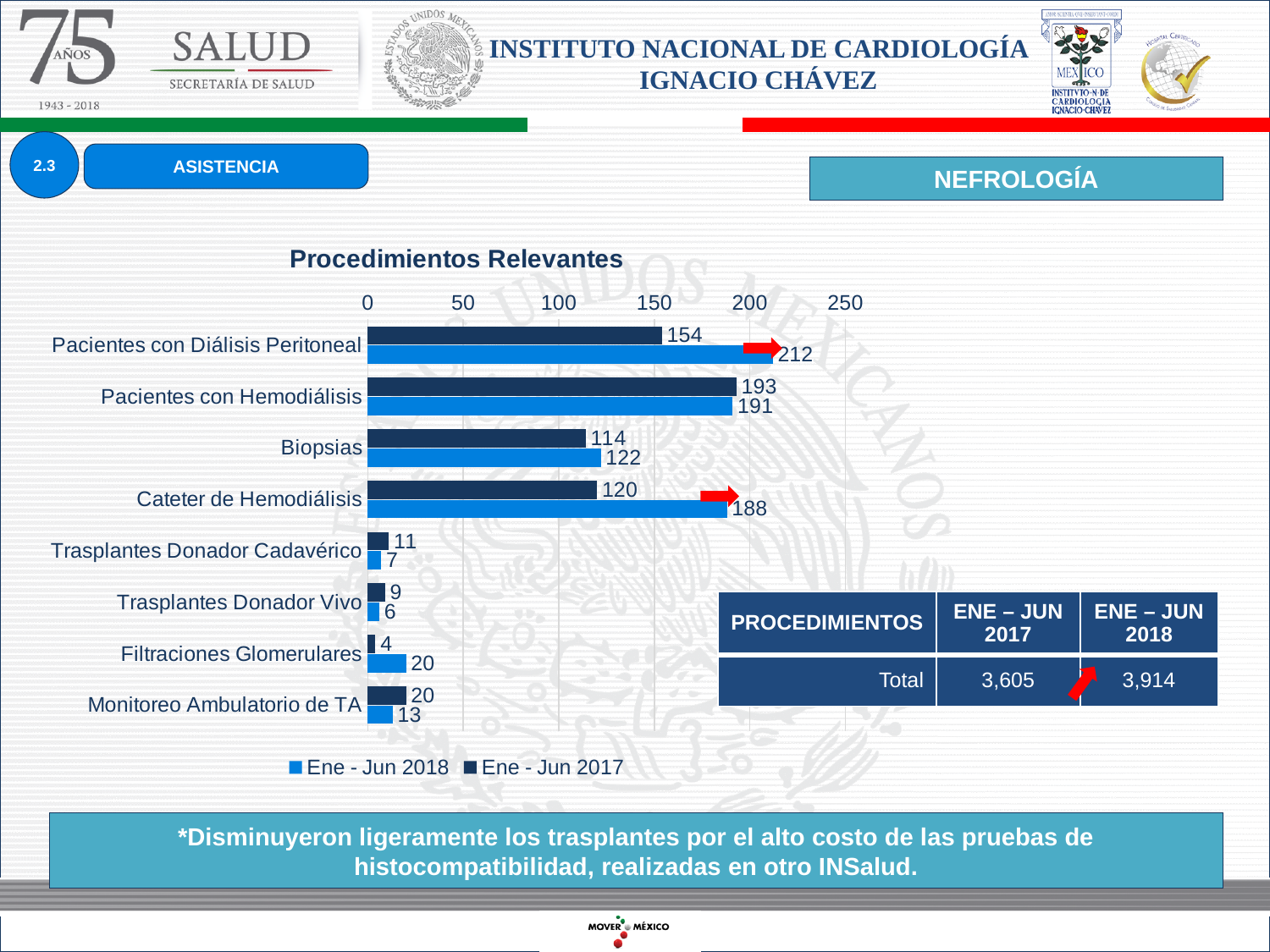
What type of chart is 'Procedimientos Relevantes'? bar chart Which series is shown in light blue in the 'Procedimientos Relevantes' chart? Ene - Jun 2018 Is the Ene - Jun 2017 value for Pacientes con Hemodiálisis greater or less than 150? greater How many categories are shown in the 'Procedimientos Relevantes' chart? 8 Which category has the lowest Ene - Jun 2017 value? Filtraciones Glomerulares How many series does the legend of the 'Procedimientos Relevantes' chart list? 2 What is the Ene - Jun 2018 value for Pacientes con Diálisis Peritoneal? 212 What is the Ene - Jun 2017 value for Cateter de Hemodiálisis? 120 What is the Ene - Jun 2018 value for Filtraciones Glomerulares? 20 Which category has the highest Ene - Jun 2018 value? Pacientes con Diálisis Peritoneal What is the difference between the Ene - Jun 2018 and Ene - Jun 2017 values for Cateter de Hemodiálisis? 68 For Biopsias, which is larger: the Ene - Jun 2017 value or the Ene - Jun 2018 value? Ene - Jun 2018